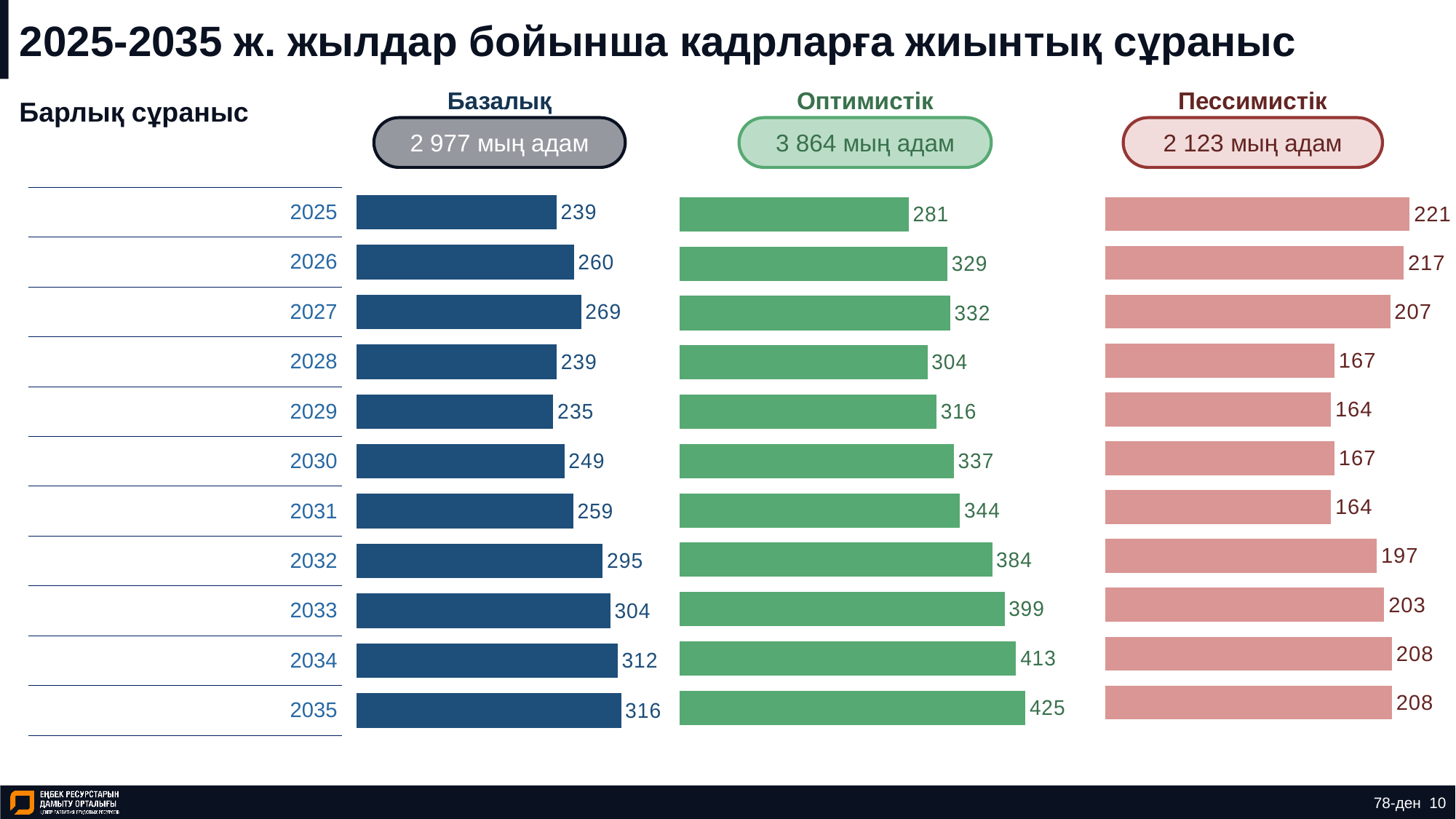
How many years are shown in the Базалық chart? 11 In the Базалық chart, what is the difference between the values for 2035 and 2025? 77 In the Базалық chart, which year has the lowest value? 2029 What kind of chart is the Оптимистік chart? Bar chart In the Пессимистік chart, what is the value for 2032? 197 In the Пессимистік chart, which year has the highest value? 2025 What total is shown in the label above the Пессимистік chart? 2 123 мың адам In the Оптимистік chart, what is the difference between the values for 2034 and 2033? 14 In the Базалық chart, what is the value for 2027? 269 In the Оптимистік chart, what is the value for 2030? 337 In the Пессимистік chart, which is larger: the value for 2026 or the value for 2033? 2026 In the Оптимистік chart, which year has the highest value? 2035